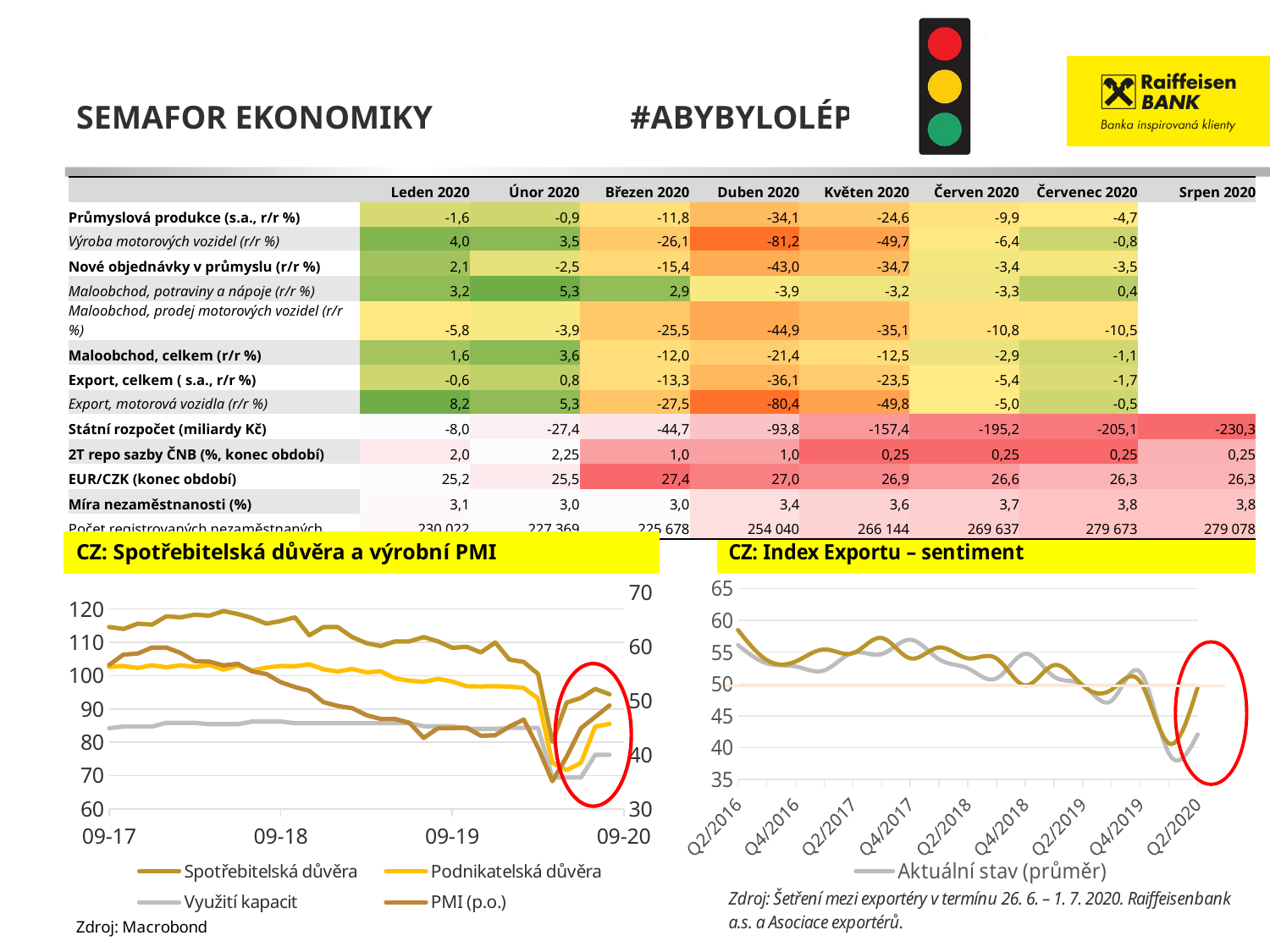
How many series does the legend of the chart 'CZ: Spotřebitelská důvěra a výrobní PMI' list? 4 In the chart 'CZ: Index Exportu – sentiment', is the value of the Aktuální stav (průměr) line at Q2/2016 greater or less than 50? greater How many entries does the legend of the chart 'CZ: Index Exportu – sentiment' list? 1 In the chart 'CZ: Spotřebitelská důvěra a výrobní PMI', which series is shown in yellow? Podnikatelská důvěra In the chart 'CZ: Spotřebitelská důvěra a výrobní PMI', does the Spotřebitelská důvěra line overall rise or fall between 09-18 and 09-20? fall What kind of chart is the chart titled 'CZ: Index Exportu – sentiment'? line chart What is the legend entry shown on the chart 'CZ: Index Exportu – sentiment'? Aktuální stav (průměr) In the chart 'CZ: Index Exportu – sentiment', do the values rise or fall between Q4/2019 and the low point in early 2020? fall How many x-axis labels are shown on the chart 'CZ: Index Exportu – sentiment'? 9 In the chart 'CZ: Spotřebitelská důvěra a výrobní PMI', is the value of Spotřebitelská důvěra at 09-17 greater or less than 110? greater What kind of chart is the chart titled 'CZ: Spotřebitelská důvěra a výrobní PMI'? line chart